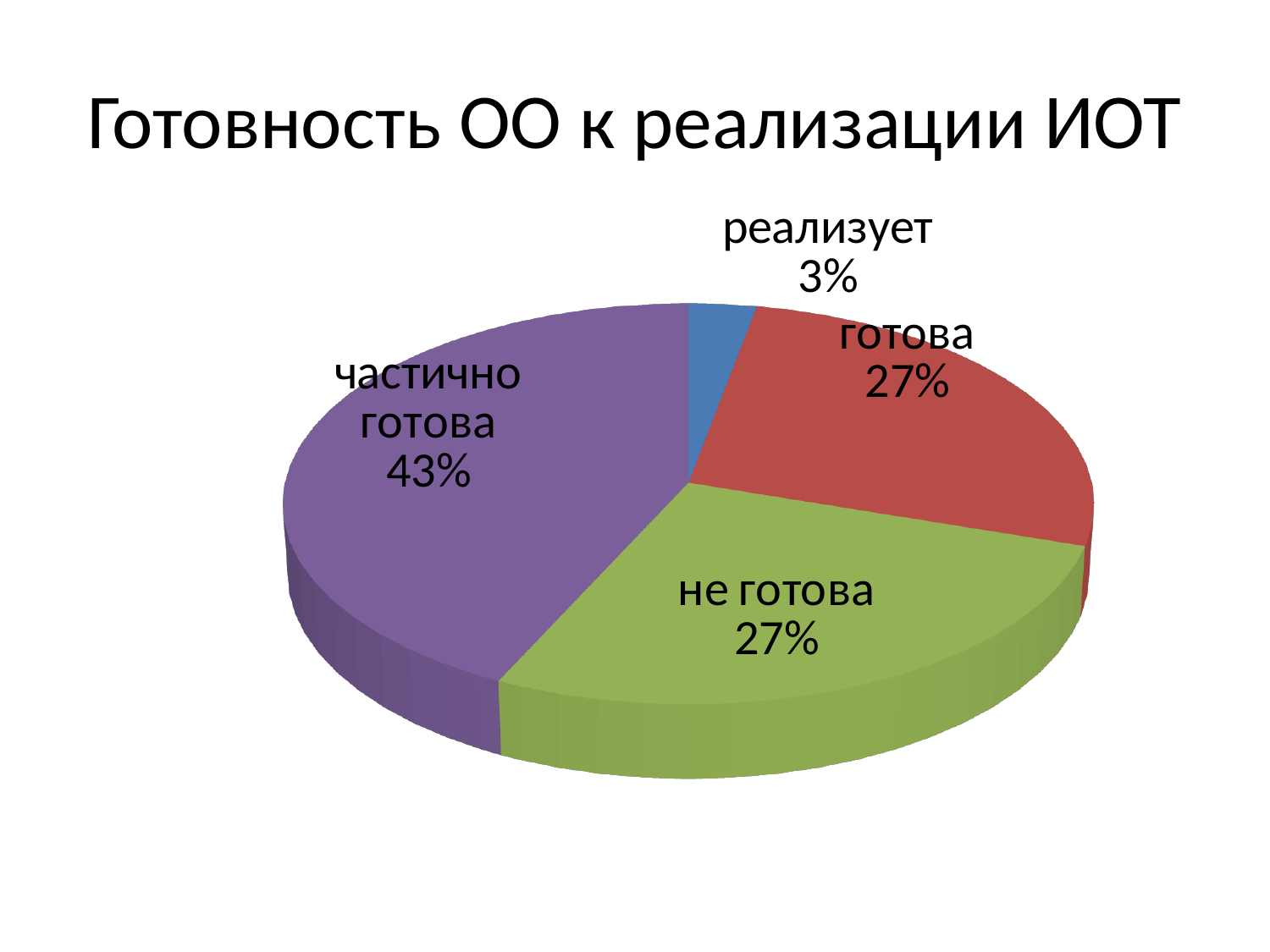
What share of the pie does "частично готова" have? 43% What is the title of the slide? Готовность ОО к реализации ИОТ What is the difference between the shares of "частично готова" and "не готова"? 16% Which is larger, the share of "частично готова" or the share of "готова"? частично готова Which category has the largest slice of the pie? частично готова How many slices does the pie chart have? 4 What share of the pie does "не готова" have? 27% Which category has the smallest slice of the pie? реализует What is the difference between the shares of "готова" and "реализует"? 24% What share of the pie does "реализует" have? 3% What kind of chart is shown on the slide? pie chart